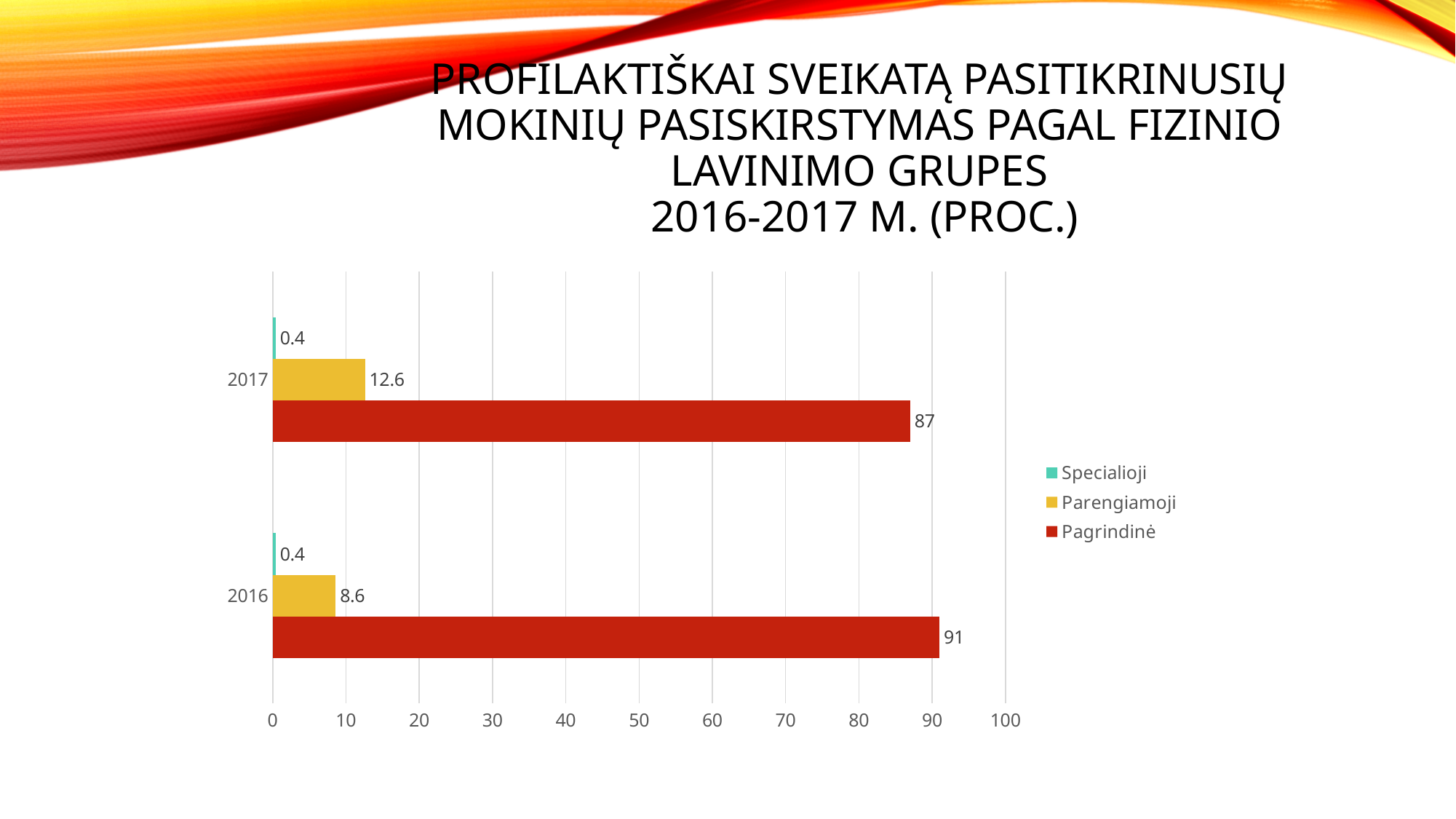
Which year has the larger Pagrindinė value, 2016 or 2017? 2016 What is the value for Specialioji in 2017? 0.4 What is the value for Pagrindinė in 2016? 91 What colour are the Pagrindinė bars? Red Which series has the lowest value in 2017? Specialioji What kind of chart is shown on the slide? Bar chart What is the value for Pagrindinė in 2017? 87 What is the difference between the Parengiamoji values for 2017 and 2016? 4 How many series does the legend list? 3 What is the value for Parengiamoji in 2016? 8.6 How many years are shown on the chart? 2 Which series has the highest value in 2016? Pagrindinė